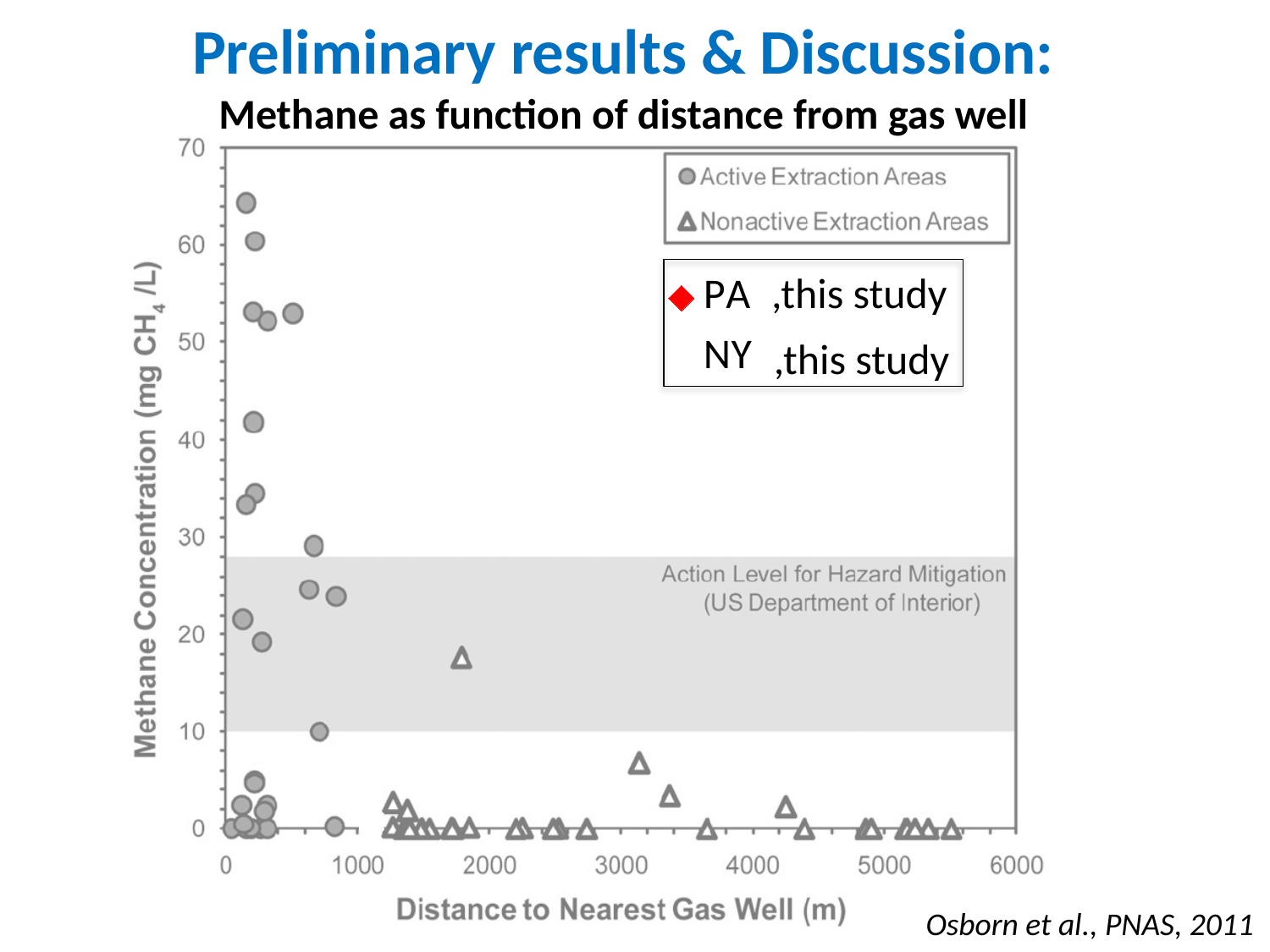
Do methane concentrations generally rise or fall as distance to the nearest gas well increases? fall How many series does the chart's legend list? 2 Which series reaches higher methane concentrations, Active Extraction Areas or Nonactive Extraction Areas? Active Extraction Areas What kind of chart is shown on the slide? Scatter plot What is the title of the chart? Methane as function of distance from gas well What is the label of the x axis? Distance to Nearest Gas Well (m) Which series is plotted with triangle markers? Nonactive Extraction Areas Is the highest methane concentration for Nonactive Extraction Areas greater or less than 20? less Is the highest methane concentration for Active Extraction Areas greater or less than 60? greater Are the Nonactive Extraction Areas points located at distances greater or less than 1000 m from the nearest gas well? greater